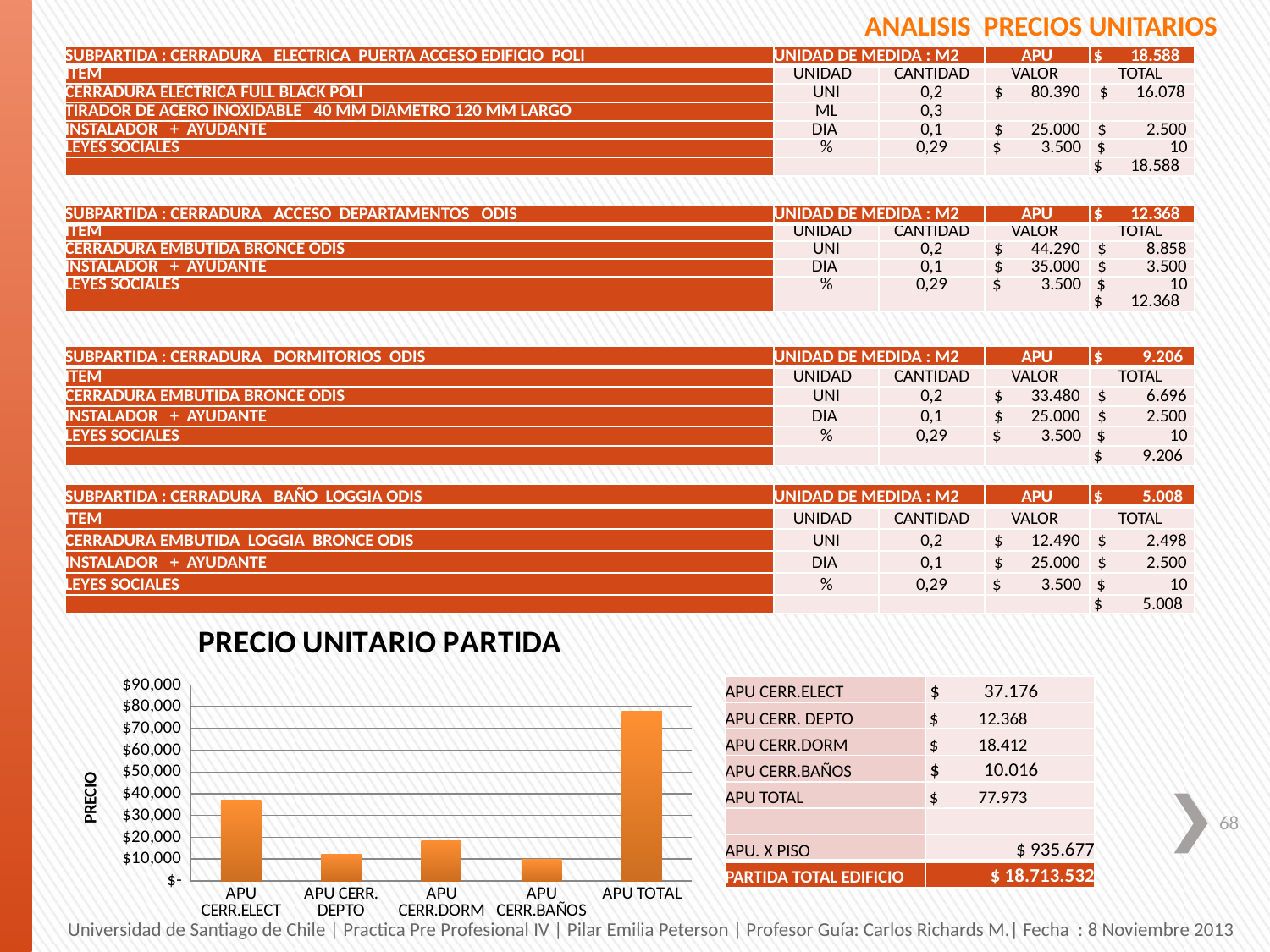
In the PRECIO UNITARIO PARTIDA chart, is the value for APU CERR.ELECT greater or less than $30,000? greater Which category has the highest bar in the PRECIO UNITARIO PARTIDA chart? APU TOTAL How many categories are plotted in the PRECIO UNITARIO PARTIDA chart? 5 In the PRECIO UNITARIO PARTIDA chart, which is larger, the bar for APU CERR.ELECT or the bar for APU CERR.DORM? APU CERR.ELECT What is the title of the chart at the bottom of the slide? PRECIO UNITARIO PARTIDA In the PRECIO UNITARIO PARTIDA chart, which is larger, the bar for APU CERR. DEPTO or the bar for APU TOTAL? APU TOTAL In the PRECIO UNITARIO PARTIDA chart, is the value for APU CERR.ELECT greater or less than $40,000? less What label is shown on the vertical axis of the PRECIO UNITARIO PARTIDA chart? PRECIO In the PRECIO UNITARIO PARTIDA chart, is the value for APU TOTAL greater or less than $70,000? greater What type of chart is shown under the title PRECIO UNITARIO PARTIDA? bar chart Which category has the lowest bar in the PRECIO UNITARIO PARTIDA chart? APU CERR.BAÑOS